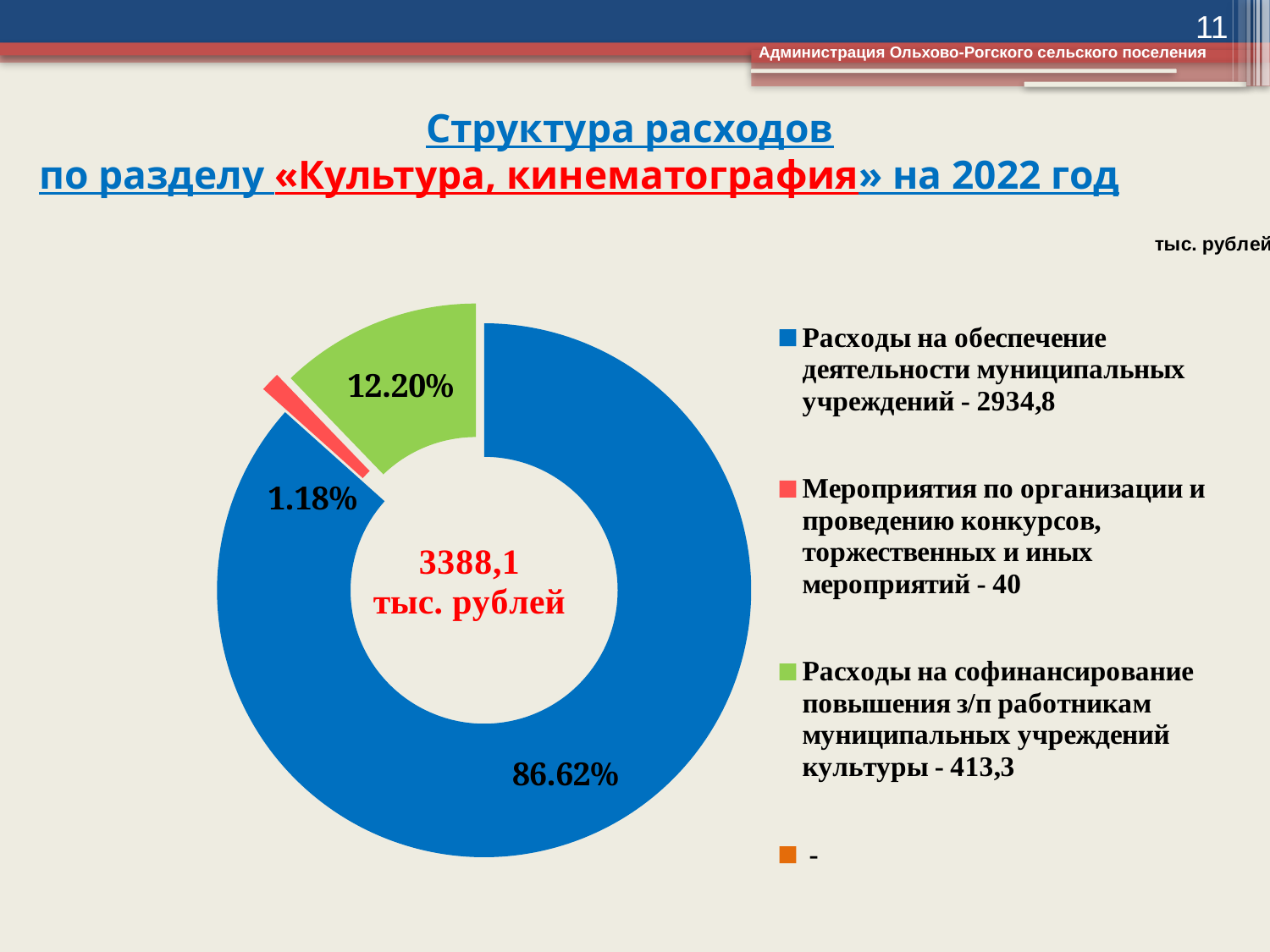
What is the difference between the values for «Расходы на обеспечение деятельности муниципальных учреждений» (2934,8) and «Расходы на софинансирование повышения з/п работникам муниципальных учреждений культуры» (413,3)? 2521,5 What share of the chart does the slice for «Расходы на софинансирование повышения з/п работникам муниципальных учреждений культуры» represent? 12.20% Which category has the largest slice of the chart? Расходы на обеспечение деятельности муниципальных учреждений What is the value (тыс. рублей) for «Расходы на софинансирование повышения з/п работникам муниципальных учреждений культуры» according to the legend? 413,3 What type of chart is shown on the slide? Doughnut (pie) chart What is the value (тыс. рублей) for «Расходы на обеспечение деятельности муниципальных учреждений» according to the legend? 2934,8 What share of the chart does the slice for «Расходы на обеспечение деятельности муниципальных учреждений» represent? 86.62% What colour is the slice representing «Расходы на софинансирование повышения з/п работникам муниципальных учреждений культуры»? Green What total amount (тыс. рублей) is shown in the centre of the doughnut chart? 3388,1 What is the value (тыс. рублей) for «Мероприятия по организации и проведению конкурсов, торжественных и иных мероприятий» according to the legend? 40 Which category has the smallest slice of the chart? Мероприятия по организации и проведению конкурсов, торжественных и иных мероприятий What share of the chart does the slice for «Мероприятия по организации и проведению конкурсов, торжественных и иных мероприятий» represent? 1.18%